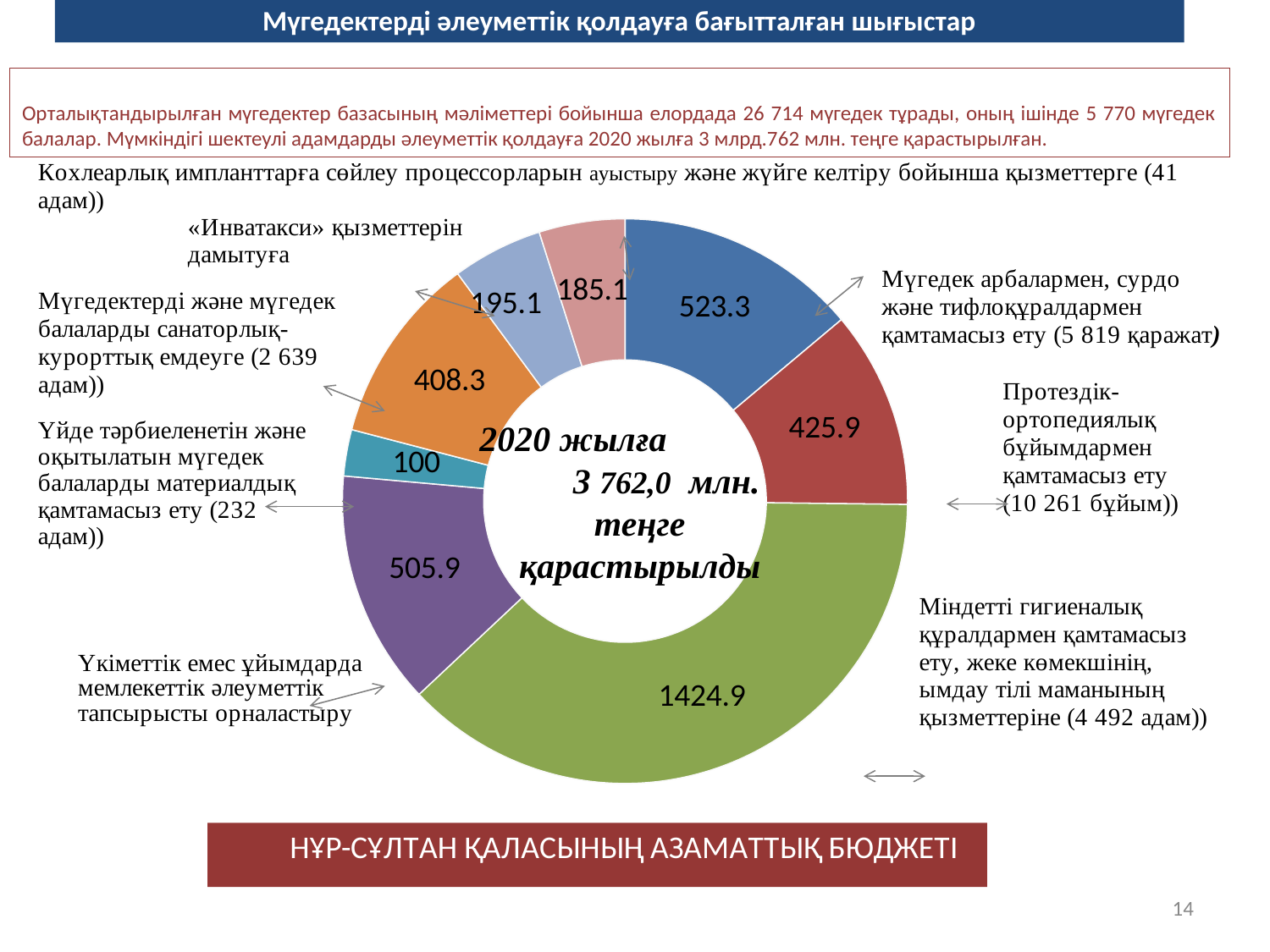
What value is shown for the segment for Мүгедек арбалармен, сурдо және тифлоқұралдармен қамтамасыз ету (5 819 қаражат)? 523.3 What value is shown for the segment for Міндетті гигиеналық құралдармен қамтамасыз ету (4 492 адам)? 1424.9 What value is shown for the segment labelled «Инватакси» қызметтерін дамытуға? 195.1 What is the difference between the largest segment (1424.9) and the smallest segment (100)? 1324.9 How many segments does the doughnut chart have? 8 What is the smallest value shown on the doughnut chart? 100 What is the difference between the segment values 523.3 and 425.9? 97.4 What value is shown for the segment for Мүгедектерді және мүгедек балаларды санаторлық-курорттық емдеуге (2 639 адам)? 408.3 Which is larger: the segment valued 505.9 or the segment valued 408.3? 505.9 What kind of chart is shown on the slide? Doughnut (pie) chart What total amount is written in the centre of the doughnut chart for 2020? 3 762,0 млн. теңге What is the largest value shown on the doughnut chart? 1424.9